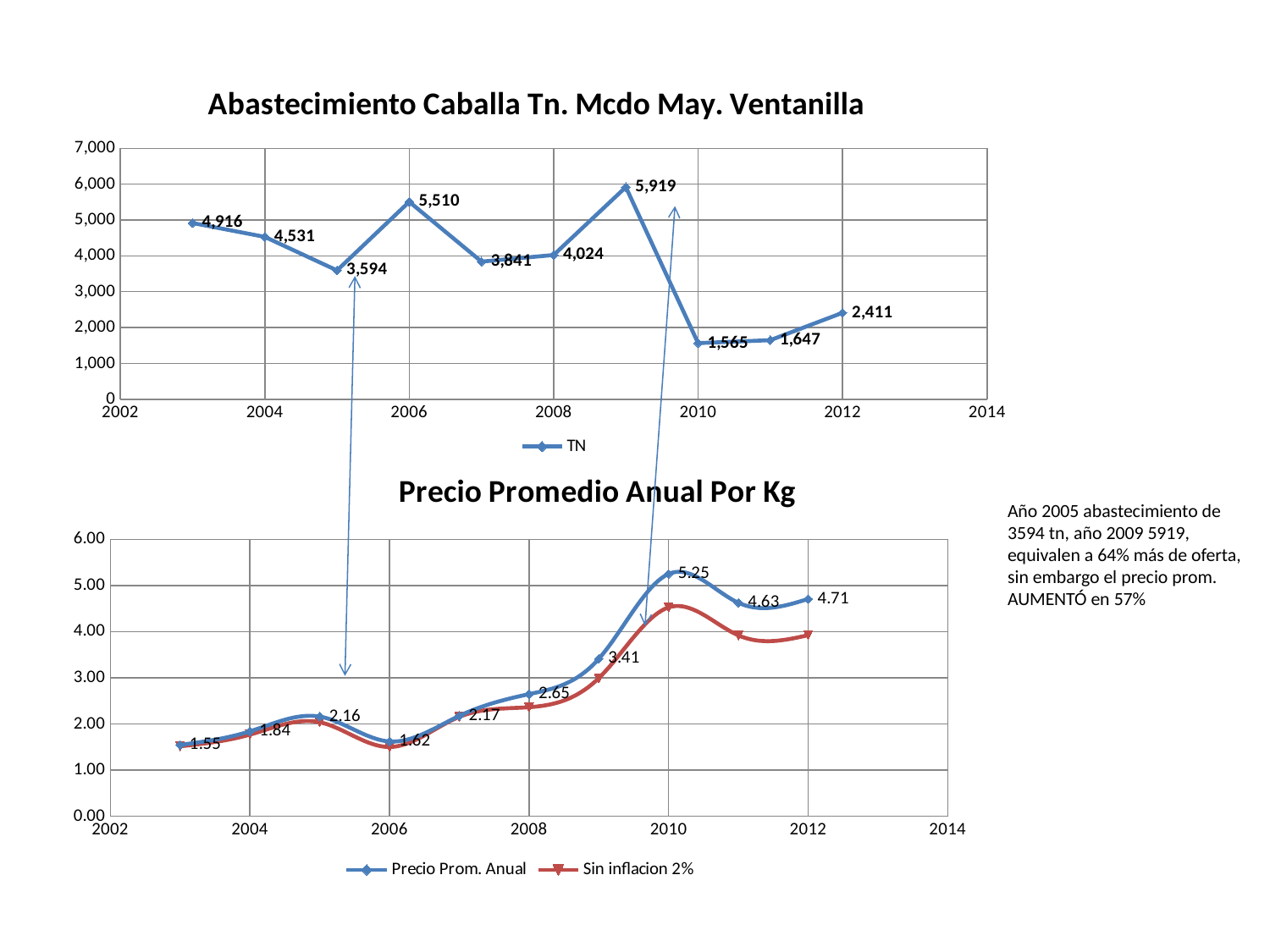
In the chart titled "Abastecimiento Caballa Tn. Mcdo May. Ventanilla", what is the TN value for 2009? 5,919 In the chart titled "Abastecimiento Caballa Tn. Mcdo May. Ventanilla", what is the difference between the TN values for 2009 and 2005? 2,325 In the chart titled "Precio Promedio Anual Por Kg", what is the Precio Prom. Anual value for 2010? 5.25 In the chart titled "Abastecimiento Caballa Tn. Mcdo May. Ventanilla", which year has the highest TN value? 2009 What kind of chart is the chart titled "Precio Promedio Anual Por Kg"? line chart In the chart titled "Abastecimiento Caballa Tn. Mcdo May. Ventanilla", which year has the lowest TN value? 2010 In the chart titled "Abastecimiento Caballa Tn. Mcdo May. Ventanilla", is the TN value for 2006 greater or less than 5,000? greater In the chart titled "Precio Promedio Anual Por Kg", which is larger, the Precio Prom. Anual value for 2011 or for 2012? 2012 In the chart titled "Precio Promedio Anual Por Kg", how many series does the legend list? 2 In the chart titled "Precio Promedio Anual Por Kg", what is the Precio Prom. Anual value for 2003? 1.55 In the chart titled "Abastecimiento Caballa Tn. Mcdo May. Ventanilla", what is the TN value for 2005? 3,594 In the chart titled "Abastecimiento Caballa Tn. Mcdo May. Ventanilla", how many data points are plotted? 10